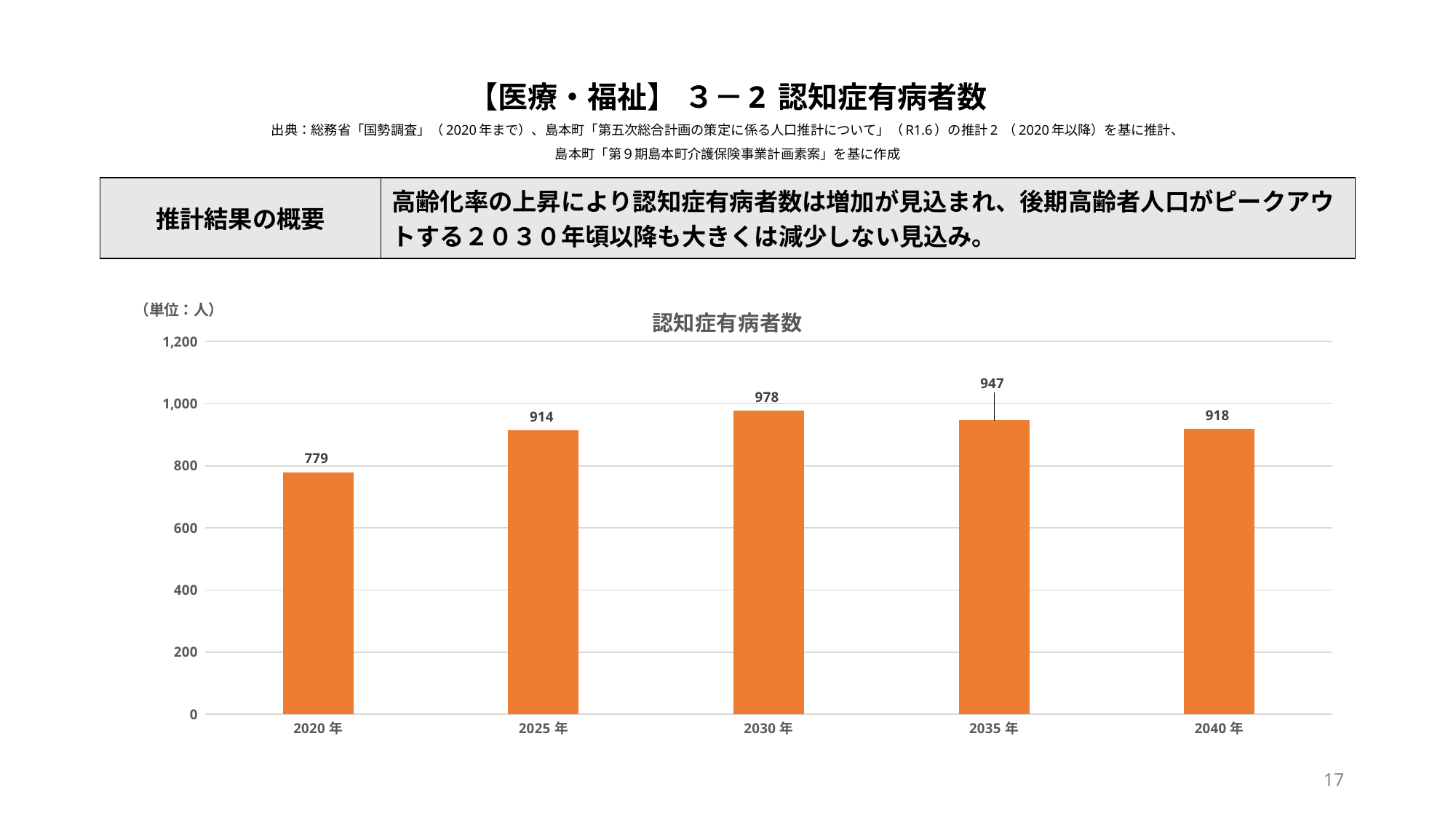
What is the difference between the values for 2035年 and 2040年 in the 認知症有病者数 chart? 29 Which year has the lowest value in the 認知症有病者数 chart? 2020年 What kind of chart is the 認知症有病者数 chart? bar chart What is the difference between the values for 2030年 and 2020年 in the 認知症有病者数 chart? 199 What unit is indicated for the values in the 認知症有病者数 chart? 人 How many years are shown on the x axis of the 認知症有病者数 chart? 5 Is the value for 2020年 in the 認知症有病者数 chart greater or less than 800? less What is the value for 2020年 in the 認知症有病者数 chart? 779 Which is larger in the 認知症有病者数 chart, the value for 2025年 or the value for 2035年? 2035年 Which year has the highest value in the 認知症有病者数 chart? 2030年 What is the value for 2040年 in the 認知症有病者数 chart? 918 What is the value for 2030年 in the 認知症有病者数 chart? 978